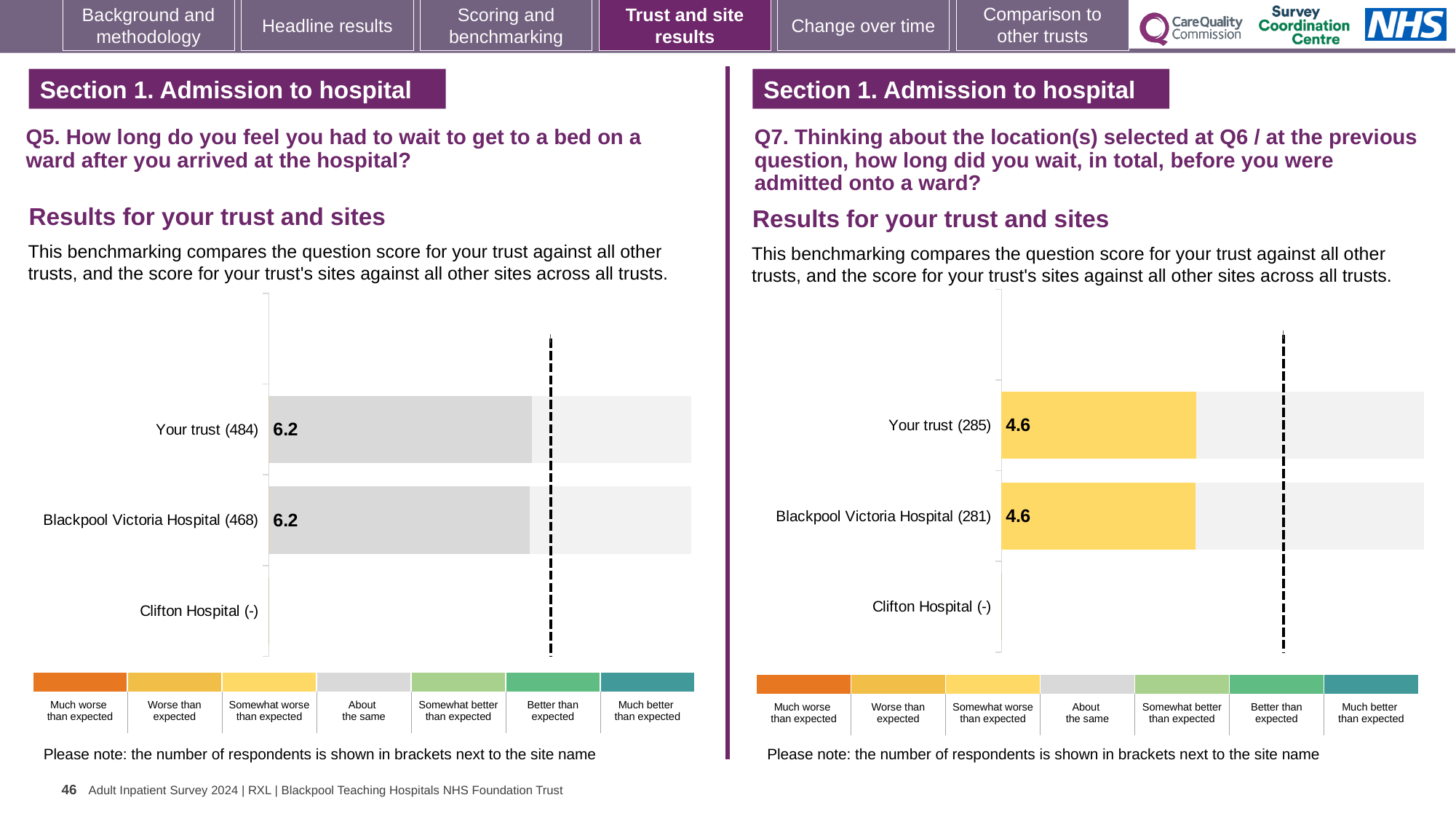
On the left chart (Q5), what is the score for Your trust? 6.2 On the right chart (Q7), what is the score for Blackpool Victoria Hospital? 4.6 On the right chart (Q7), what is the score for Your trust? 4.6 On the left chart (Q5), what is the difference between the score for Your trust and the score for Blackpool Victoria Hospital? 0 On the left chart (Q5), what is the score for Blackpool Victoria Hospital? 6.2 On the right chart (Q7), how many respondents are shown in brackets for Blackpool Victoria Hospital? 281 How many site/trust categories are listed on the left chart (Q5)? 3 On the right chart (Q7), which benchmarking category does the colour of the Your trust bar correspond to in the legend? Somewhat worse than expected On the left chart (Q5), which benchmarking category does the colour of the Blackpool Victoria Hospital bar correspond to in the legend? About the same What kind of chart is used on the right (Q7)? Bar chart On the right chart (Q7), what is the difference between the score for Your trust and the score for Blackpool Victoria Hospital? 0 On the left chart (Q5), how many respondents are shown in brackets for Your trust? 484